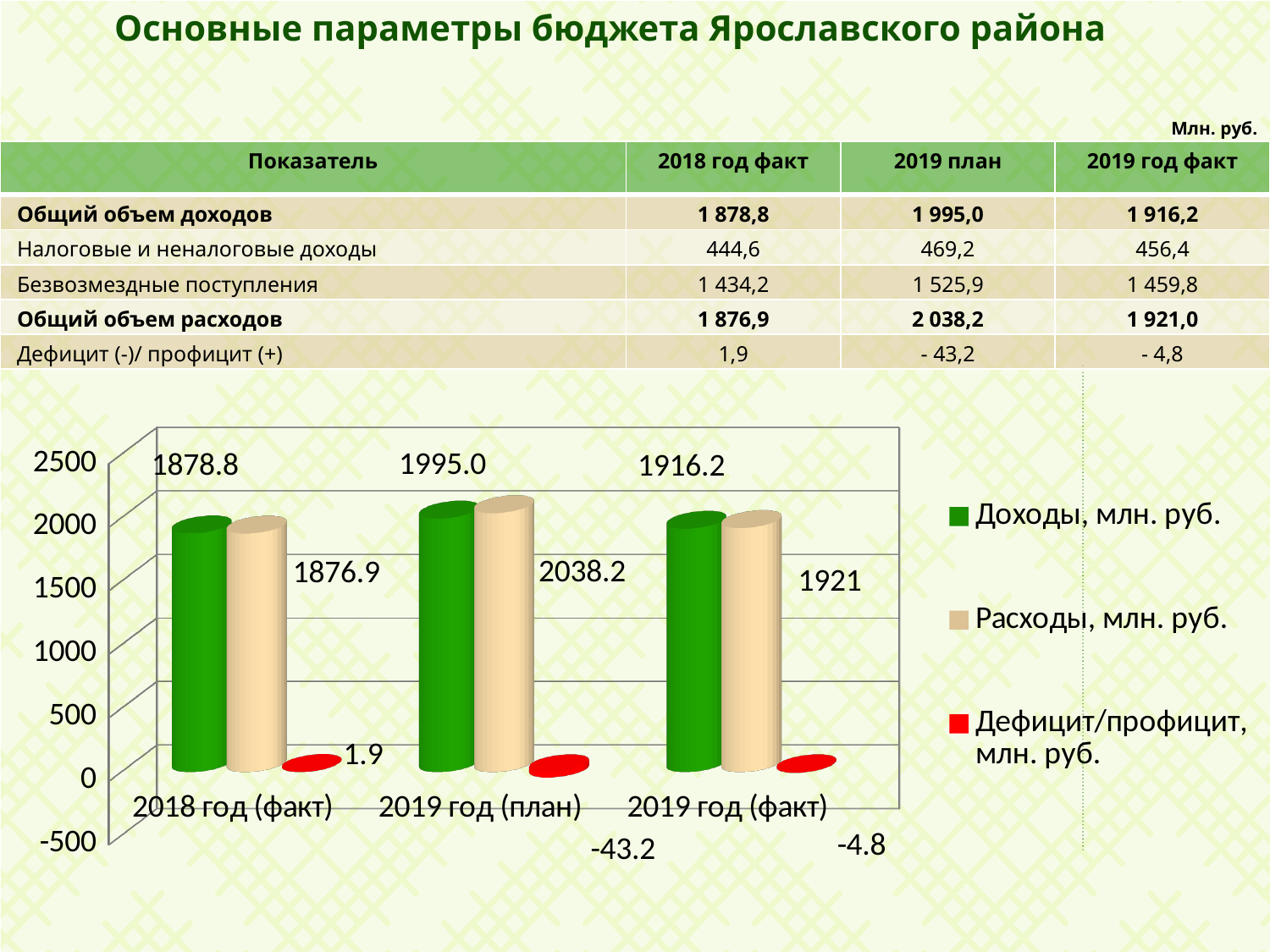
What is the value of Доходы, млн. руб. for 2018 год (факт) in the chart? 1878.8 What is the difference between Расходы and Доходы for 2019 год (план) in the chart? 43.2 What is the value of Дефицит/профицит, млн. руб. for 2019 год (план) in the chart? -43.2 How many series does the chart legend list? 3 What is the value of Доходы, млн. руб. for 2019 год (план) in the chart? 1995.0 How many categories are shown on the x axis of the chart? 3 In which category is Расходы, млн. руб. highest in the chart? 2019 год (план) Which colour represents Дефицит/профицит, млн. руб. in the chart legend? red What kind of chart is shown on the slide? bar chart What is the value of Расходы, млн. руб. for 2019 год (факт) in the chart? 1921 In which category is Доходы, млн. руб. lowest in the chart? 2018 год (факт) Which is larger in the chart for 2019 год (факт): Доходы or Расходы? Расходы